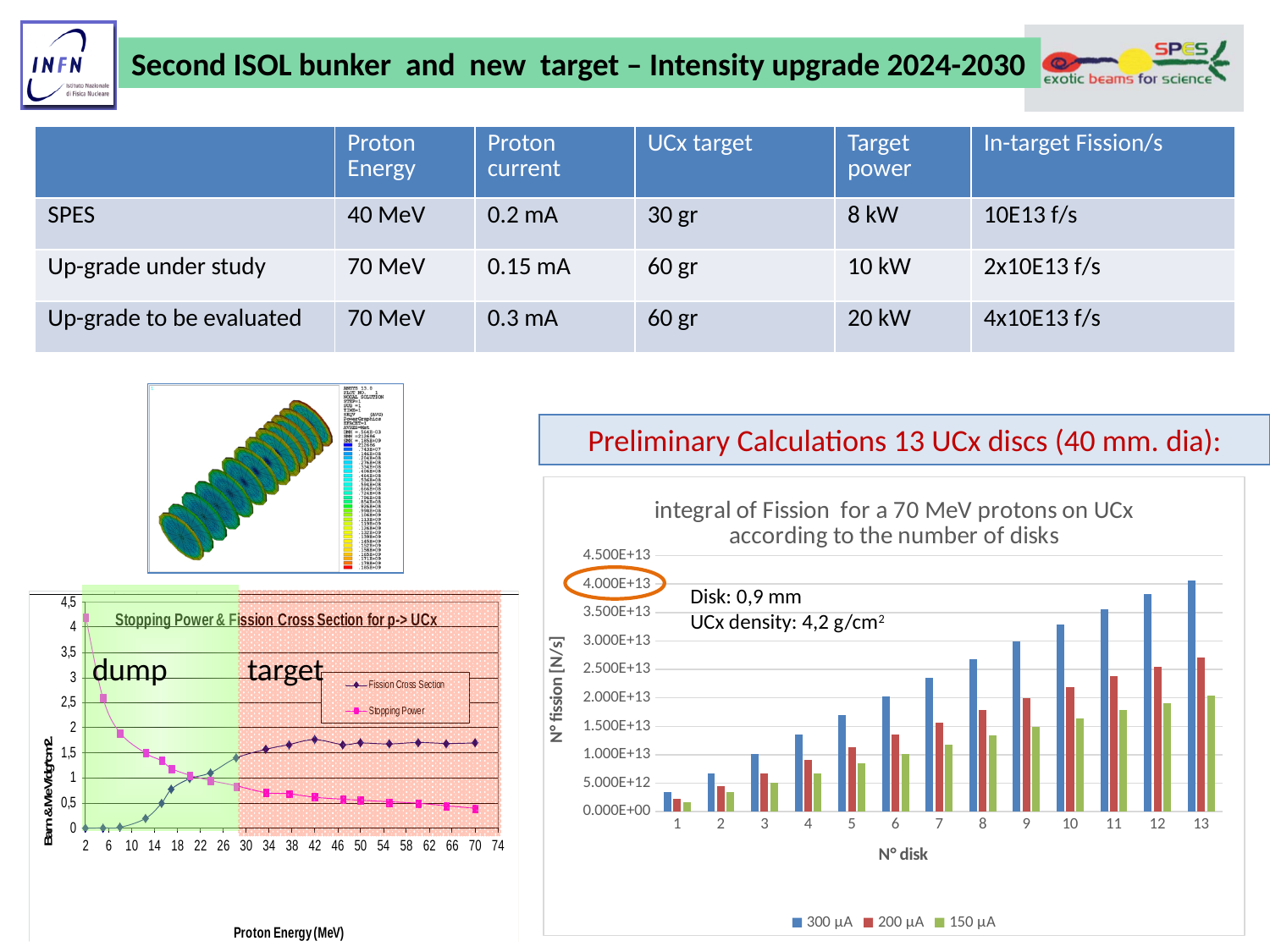
In the 'Stopping Power & Fission Cross Section for p-> UCx' chart, does the Stopping Power series rise or fall as proton energy increases? fall In the 'integral of Fission' bar chart, is the 150 µA value at disk 13 greater or less than 2.500E+13? less In the 'integral of Fission' bar chart, at disk 13, which is larger: the 300 µA value or the 150 µA value? 300 µA In the 'integral of Fission' bar chart, how many series does the legend list? 3 In the 'integral of Fission' bar chart, how many disk numbers are shown on the x axis? 13 What type of chart is the 'integral of Fission for a 70 MeV protons on UCx according to the number of disks' chart? bar chart In the 'integral of Fission' bar chart, what is the x-axis title? N° disk In the 'Stopping Power & Fission Cross Section for p-> UCx' chart, how many series does the legend list? 2 In the 'Stopping Power & Fission Cross Section for p-> UCx' chart, is the Stopping Power value at 2 MeV greater or less than 4? greater In the 'integral of Fission' bar chart, is the 300 µA value at disk 10 greater or less than 3.000E+13? greater In the 'integral of Fission' bar chart, which disk number has the highest value for the 300 µA series? 13 In the 'integral of Fission' bar chart, do the values rise or fall as the number of disks increases? rise